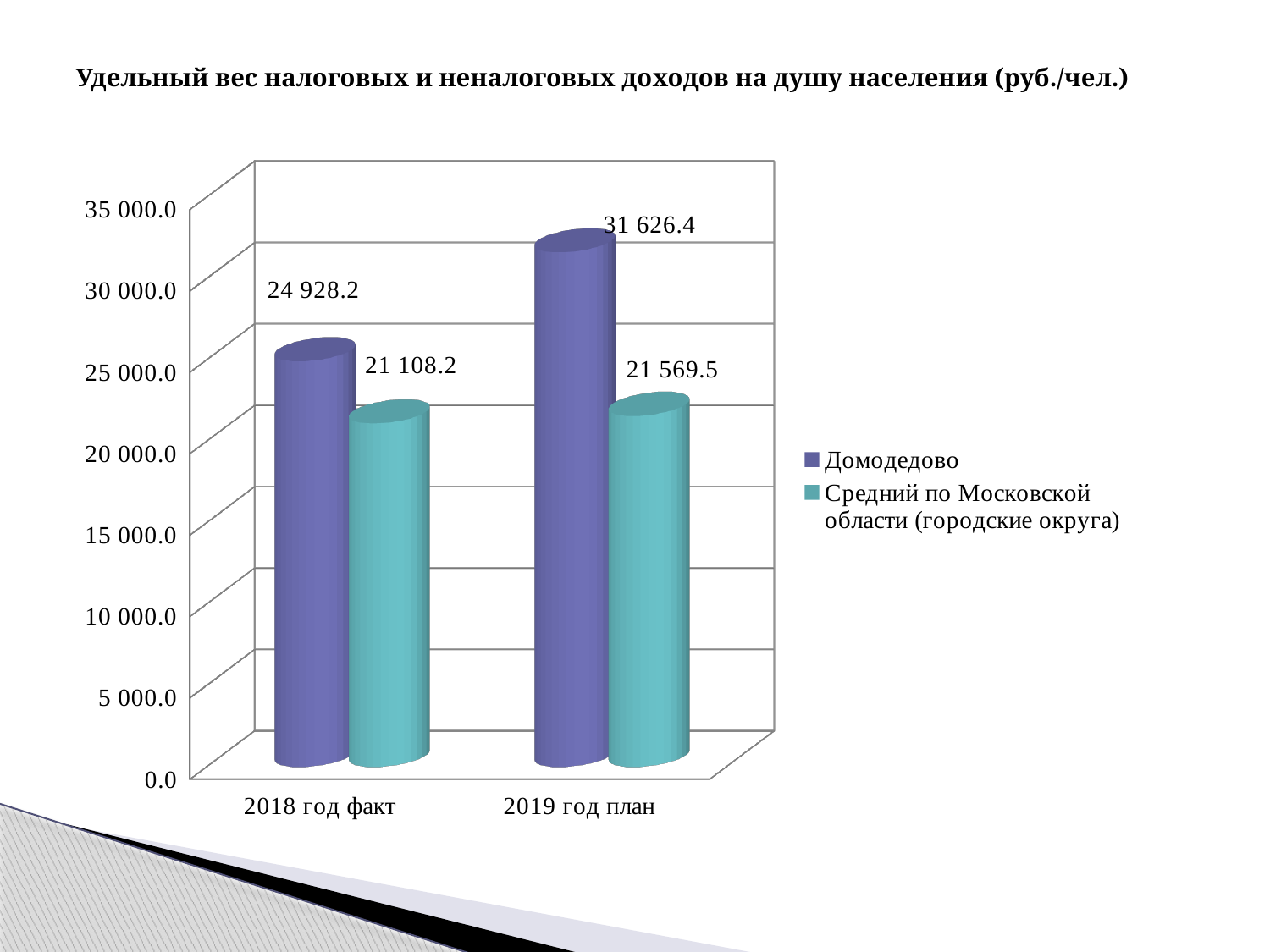
What kind of chart is shown on the slide? Bar chart What is the value for Средний по Московской области (городские округа) in 2019 год план? 21 569.5 What is the value for Домодедово in 2018 год факт? 24 928.2 How many series does the legend list? 2 Which bar has the highest value on the chart? Домодедово, 2019 год план What is the difference between Домодедово and Средний по Московской области (городские округа) in 2019 год план? 10 056.9 What is the difference between the Домодедово values for 2019 год план and 2018 год факт? 6 698.2 What is the value for Домодедово in 2019 год план? 31 626.4 What is the value for Средний по Московской области (городские округа) in 2018 год факт? 21 108.2 Which bar has the lowest value on the chart? Средний по Московской области (городские округа), 2018 год факт How many categories are shown on the x axis? 2 Which is larger in 2018 год факт: Домодедово or Средний по Московской области (городские округа)? Домодедово